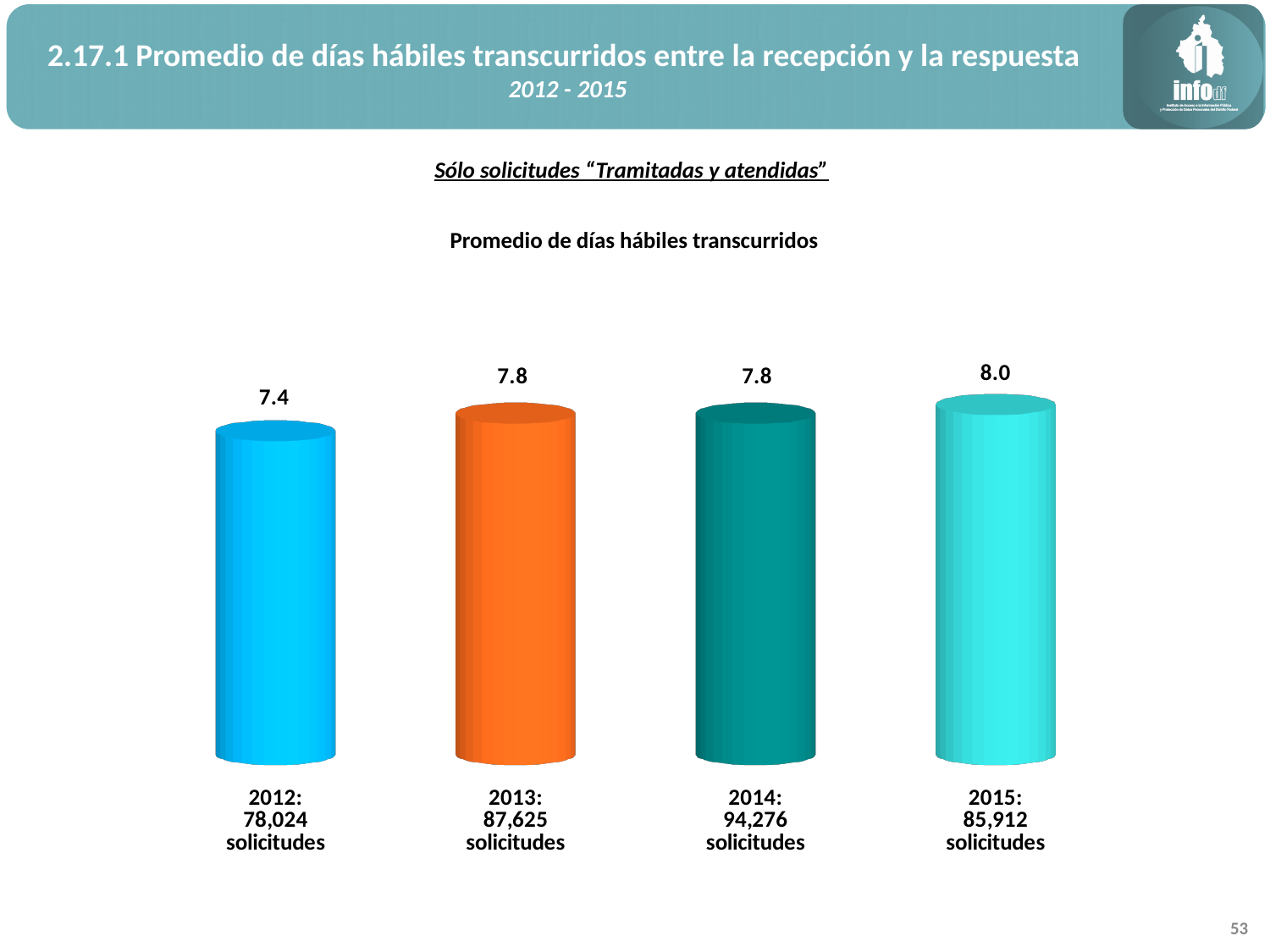
What is the difference between the average for 2015 and the average for 2012? 0.6 Do the average values rise or fall from 2012 to 2015? rise How many years are shown in the chart? 4 What is the difference between the average for 2013 and the average for 2012? 0.4 Which year has the highest average number of business days elapsed? 2015 What kind of chart is shown on the slide? bar chart Which is larger, the average for 2012 or the average for 2015? 2015 Which year has the lowest average number of business days elapsed? 2012 What is the average number of business days elapsed for 2014? 7.8 What is the average number of business days elapsed for 2012? 7.4 What is the average number of business days elapsed for 2015? 8.0 How many solicitudes are listed under the 2014 bar? 94,276